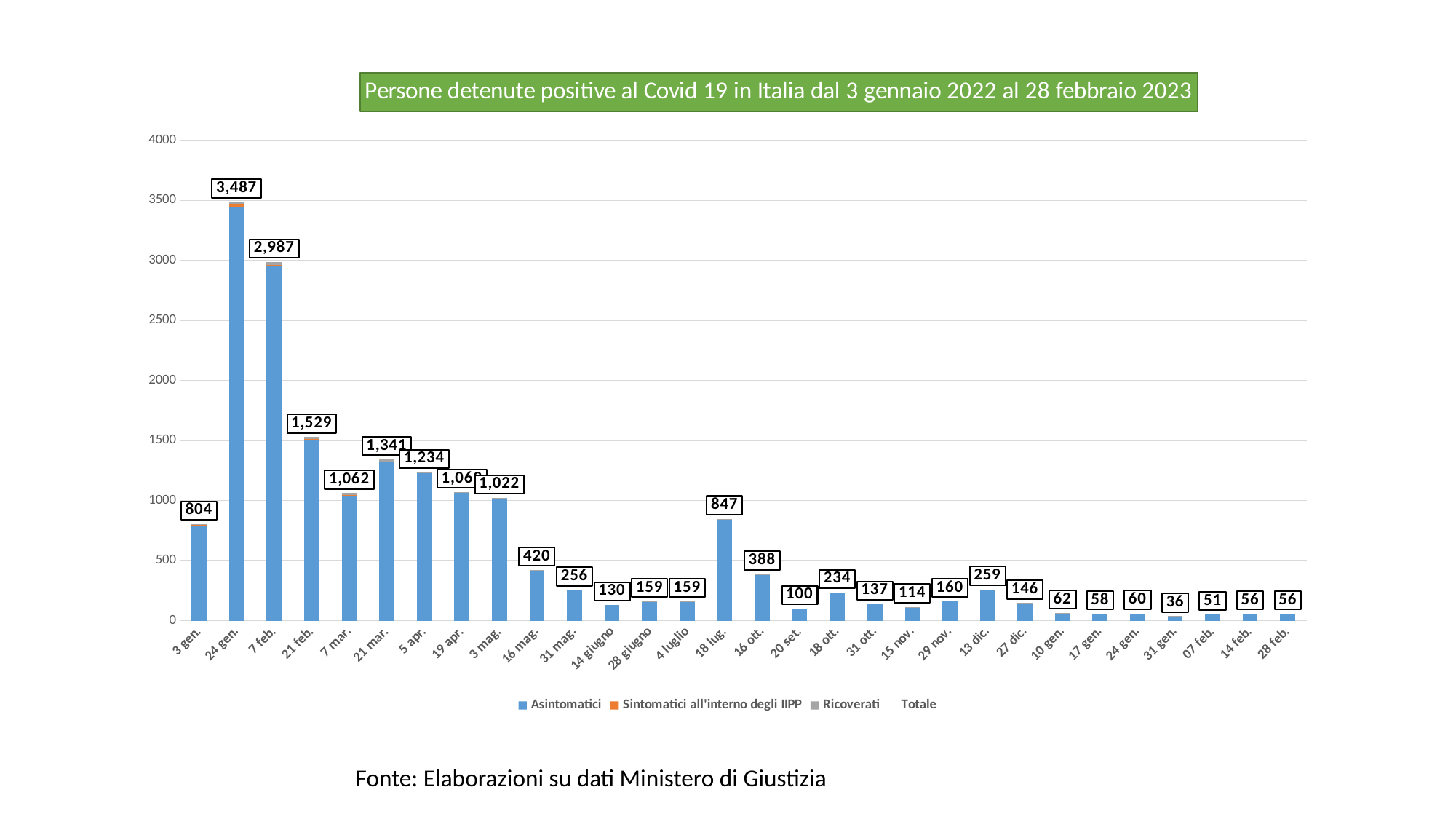
What is the total value labelled for 3 gen.? 804 Which is larger, the total for 18 lug. or the total for 16 ott.? 18 lug. What is the total value labelled for 16 mag.? 420 Is the total for 21 feb. greater or less than 1500? greater What is the difference between the totals for 24 gen. (3,487) and 7 feb. (2,987)? 500 What kind of chart is shown on the slide? Bar chart How many series does the legend list? 4 What is the total value labelled for 13 dic.? 259 How many dates are shown on the x axis? 30 Which date has the lowest total? 31 gen. Which date has the highest total? 24 gen. (2022) What is the total value labelled for 18 lug.? 847